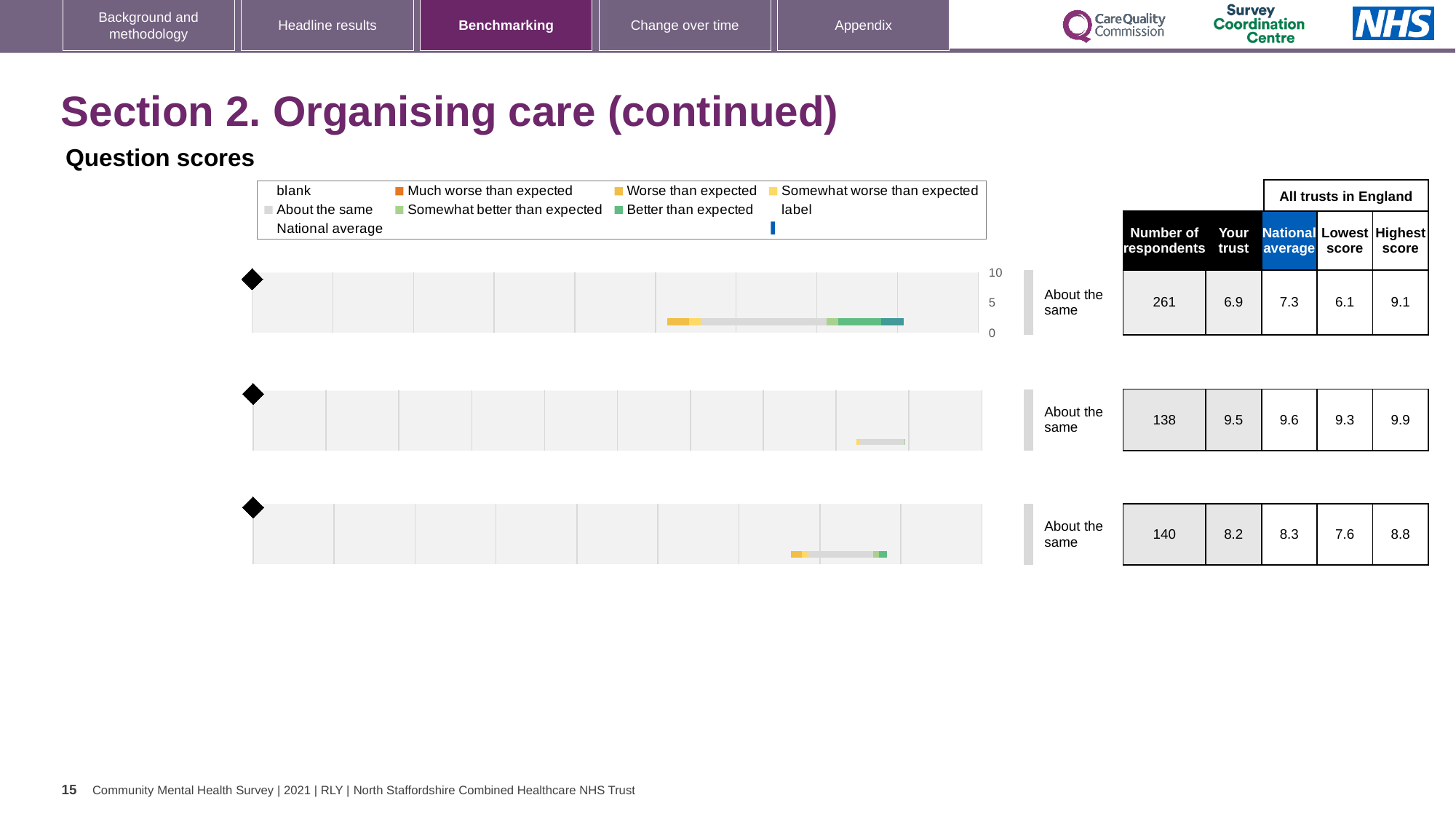
For the bottom chart, what is the difference between the highest score and the lowest score? 1.2 What benchmarking category is shown next to all three charts? About the same How many benchmarking charts are shown on the slide? 3 For the middle chart, what is the highest score among all trusts in England? 9.9 For the top chart, what is the number of respondents shown in the table? 261 For the top chart, what is the 'Your trust' score? 6.9 For the top chart, what is the national average score? 7.3 For the top chart, which is larger: the 'Your trust' score or the national average? National average For the top chart, what is the difference between the highest score and the lowest score? 3.0 For the bottom chart, what is the lowest score among all trusts in England? 7.6 What kind of chart is used for the benchmarking displays on this slide? bar chart For the middle chart, what is the 'Your trust' score? 9.5